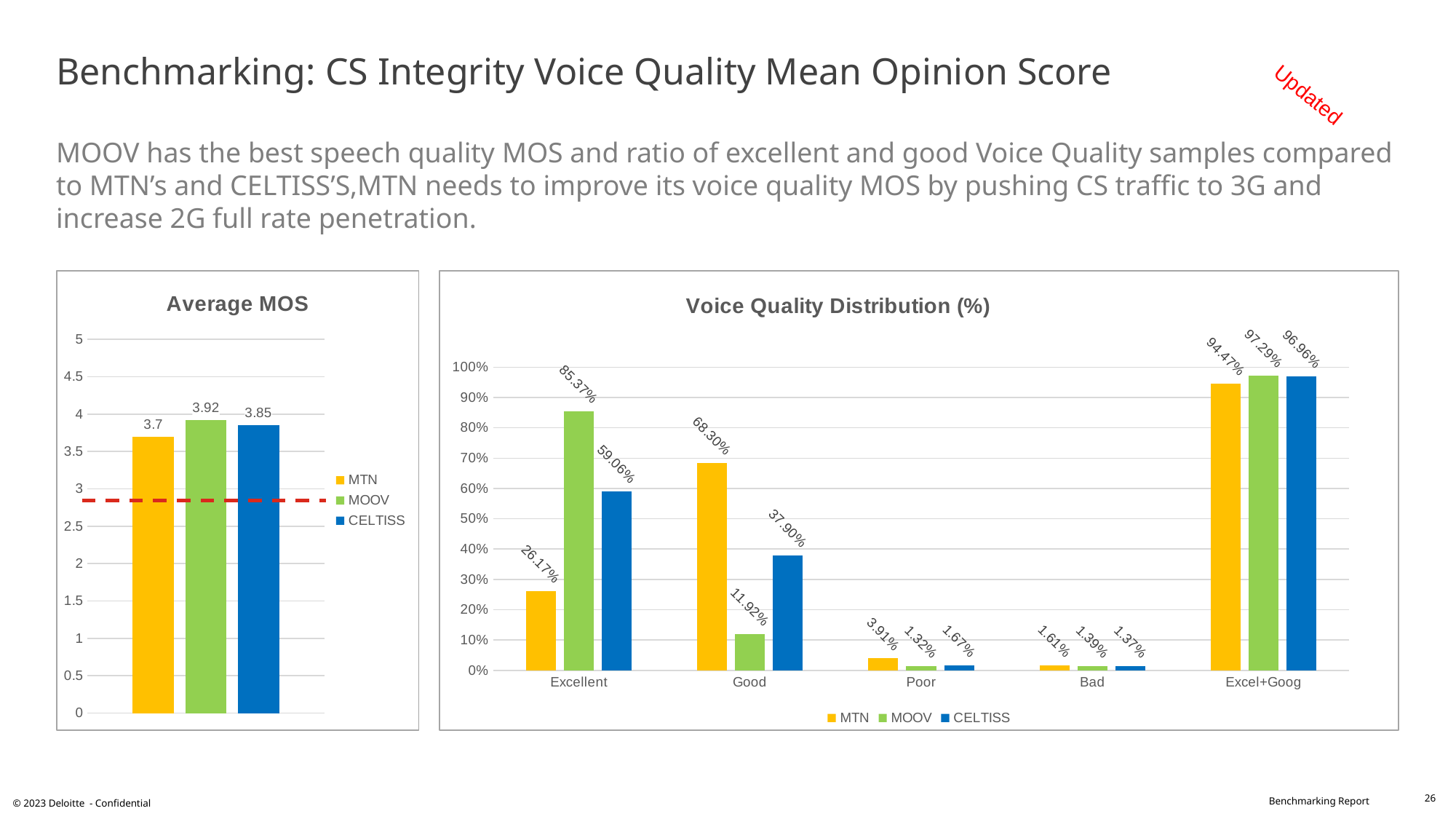
What kind of chart is the Voice Quality Distribution (%) chart? Bar chart In the Average MOS chart, how many series does the legend list? 3 In the Voice Quality Distribution (%) chart, what is the difference between MOOV's and MTN's Excel+Goog values? 2.82% In the Voice Quality Distribution (%) chart, which operator has the highest value for Excellent? MOOV In the Average MOS chart, what is the difference between MOOV's and MTN's values? 0.22 In the Voice Quality Distribution (%) chart, what is MOOV's value for Poor? 1.32% In the Voice Quality Distribution (%) chart, which is larger for Good: MTN or MOOV? MTN In the Average MOS chart, which operator has the lowest average MOS? MTN In the Voice Quality Distribution (%) chart, what is MTN's value for Excellent? 26.17% In the Voice Quality Distribution (%) chart, how many categories are shown on the x axis? 5 In the Voice Quality Distribution (%) chart, what is CELTISS's value for Good? 37.90% In the Average MOS chart, what is the value for MOOV? 3.92